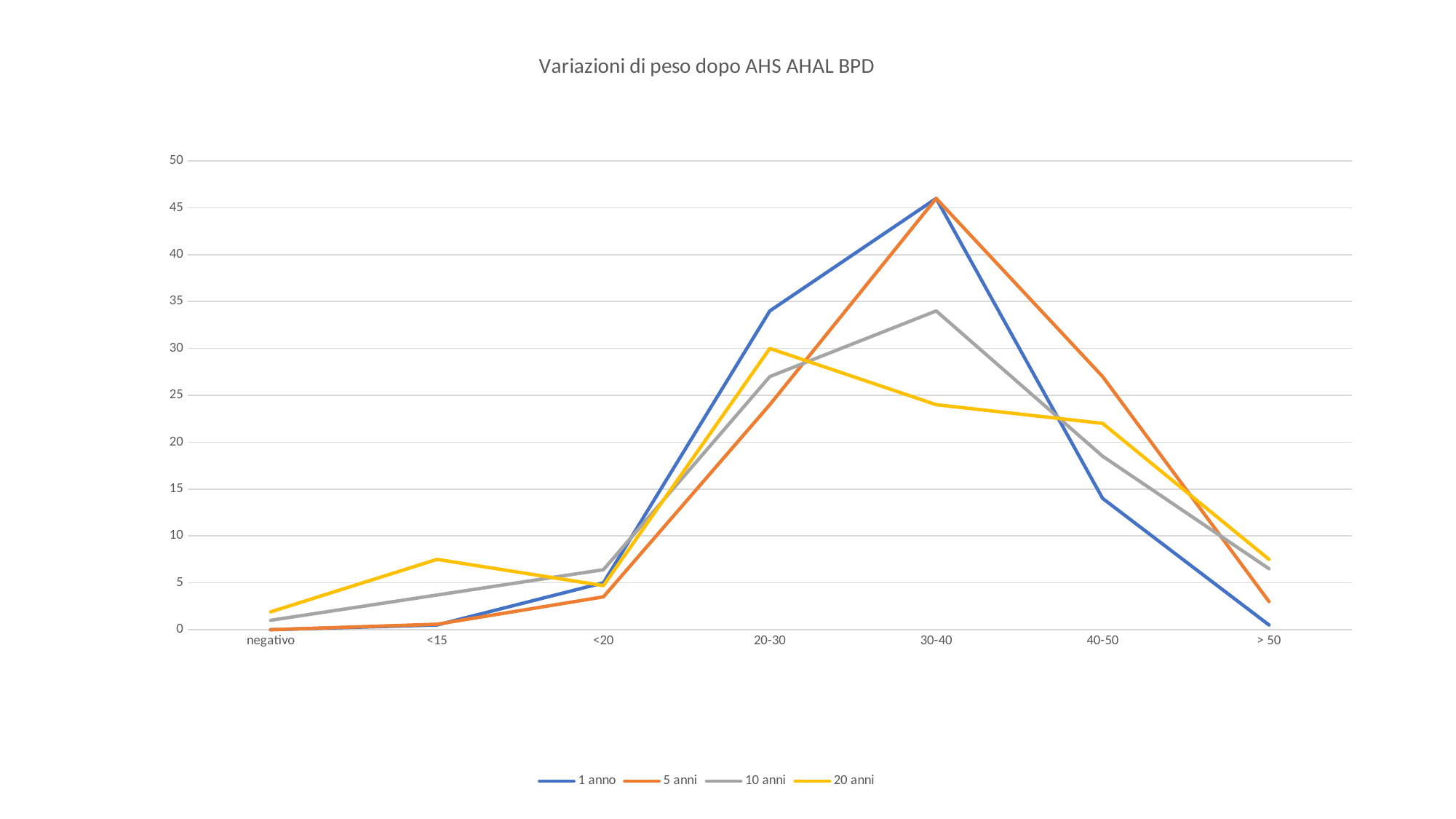
How many series does the legend list? 4 Does the '1 anno' series rise or fall from 30-40 to > 50? fall How many categories are shown on the x axis? 7 For the series '20 anni', which category has the highest value? 20-30 For the series '20 anni', which category has the lowest value? negativo Is the value for '1 anno' at 20-30 greater or less than 30? greater What kind of chart is shown on the slide? line chart At 40-50, which series has the larger value, '5 anni' or '1 anno'? 5 anni Is the value for '5 anni' at > 50 greater or less than 5? less Is the value for '10 anni' at 30-40 greater or less than 30? greater For the series '1 anno', which category has the highest value? 30-40 What is the title of the chart? Variazioni di peso dopo AHS AHAL BPD